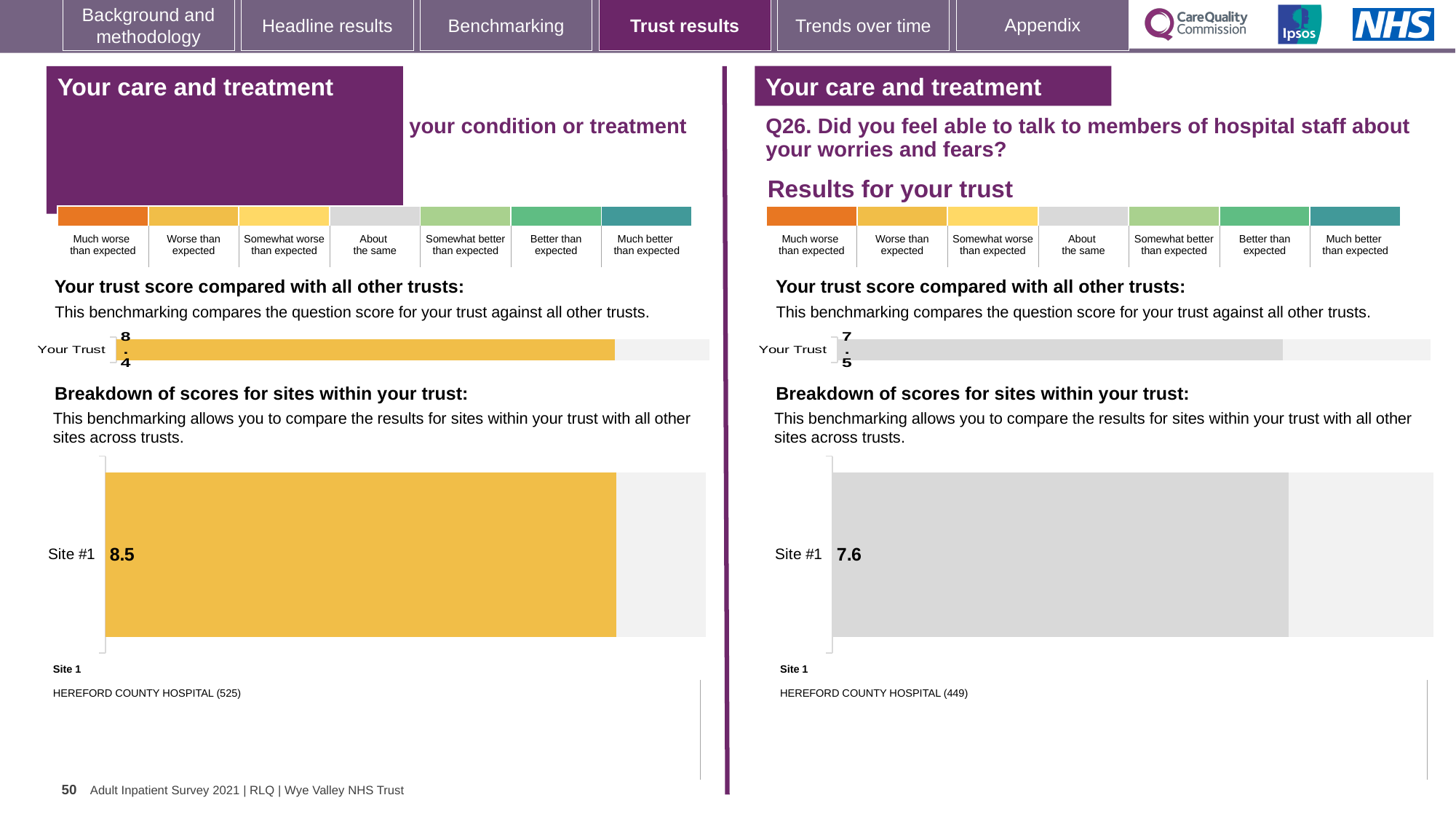
On the left half of the slide, what is the score shown for Site #1 in the breakdown of scores for sites chart? 8.5 On the right half of the slide (Q26), is the Site #1 score greater or less than the Your Trust score? greater On the left half of the slide, what is the value shown for Your Trust in the trust score chart? 8.4 On the right half of the slide (Q26), what is the score shown for Site #1 in the breakdown of scores for sites chart? 7.6 What is the difference between the Your Trust score on the left half of the slide and the Your Trust score on the right half (Q26)? 0.9 On the right half of the slide (Q26), what is the value shown for Your Trust in the trust score chart? 7.5 On the left half of the slide, which benchmark category does the yellow colour of the Site #1 bar correspond to? Worse than expected On the right half of the slide (Q26), which benchmark category does the grey colour of the Site #1 bar correspond to? About the same Which Site #1 score is larger: the one on the left half of the slide or the one on the right half (Q26)? Left half (8.5) How many sites are shown in the breakdown of scores chart on the left half of the slide? 1 What is the difference between the Site #1 score on the left half of the slide and the Site #1 score on the right half (Q26)? 0.9 What type of chart is used to show the Site #1 score on the right half of the slide? Bar chart